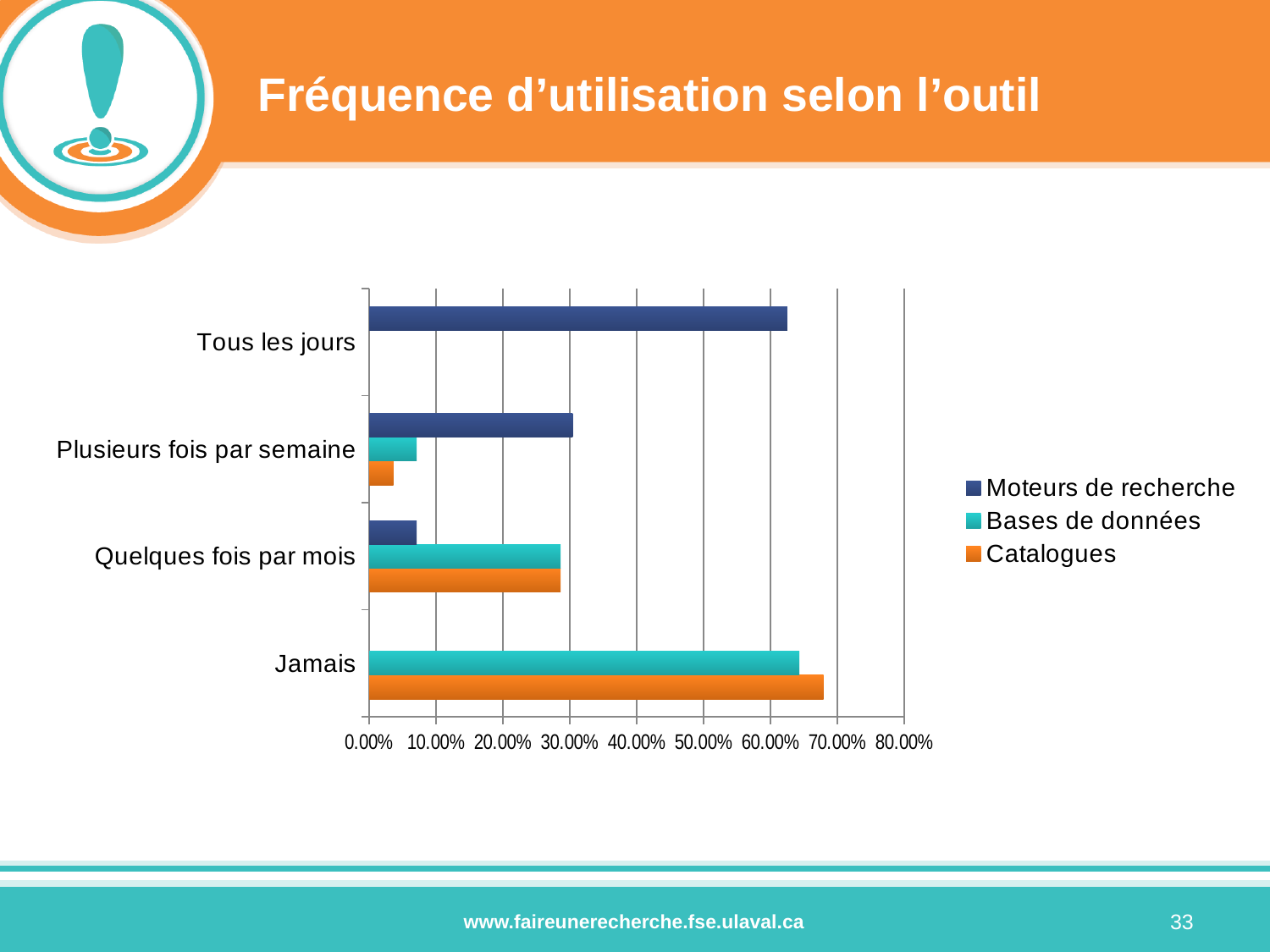
Is the value for Moteurs de recherche in the Plusieurs fois par semaine category greater or less than 20.00%? greater What kind of chart is shown on the slide? bar chart How many frequency categories are shown on the chart? 4 Is the value for Catalogues in the Jamais category greater or less than 60.00%? greater How many series does the legend list? 3 In which category is the Bases de données bar the longest? Jamais In which category is the Moteurs de recherche bar the longest? Tous les jours Which series is shown in orange in the legend? Catalogues In the Plusieurs fois par semaine category, which is larger: Moteurs de recherche or Bases de données? Moteurs de recherche Is the value for Bases de données in the Quelques fois par mois category greater or less than 20.00%? greater